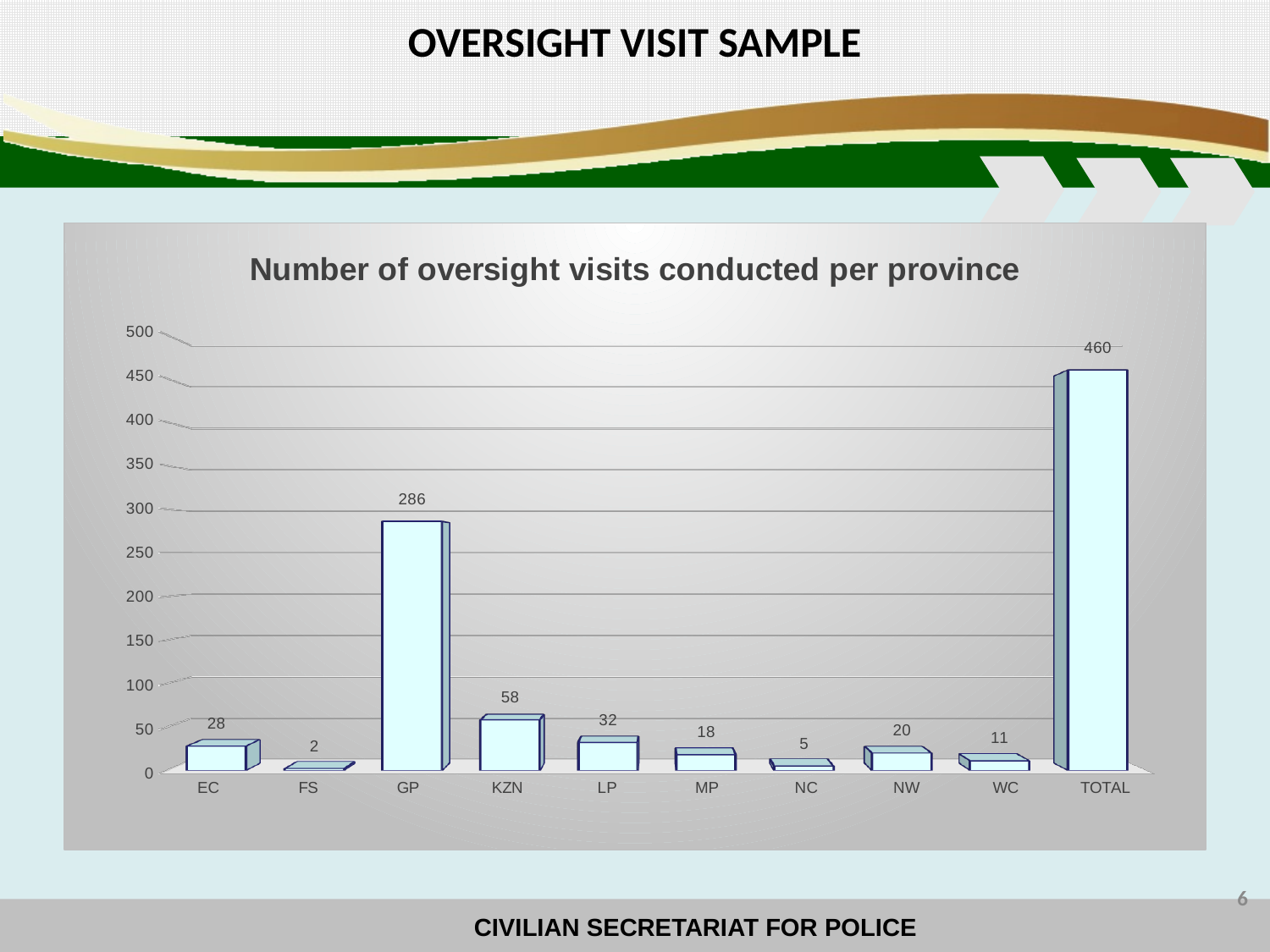
What is the number of oversight visits conducted in GP? 286 What is the number of oversight visits conducted in KZN? 58 What is the difference between the number of oversight visits in GP and KZN? 228 Which province has the lowest number of oversight visits? FS What is the title of the chart? Number of oversight visits conducted per province Is the value for GP greater or less than 250? greater What kind of chart is shown on the slide? bar chart Which has more oversight visits, LP or MP? LP Excluding the TOTAL bar, which province has the highest number of oversight visits? GP How many categories are shown on the x axis of the chart? 10 What is the number of oversight visits conducted in FS? 2 What value is shown for the TOTAL bar? 460